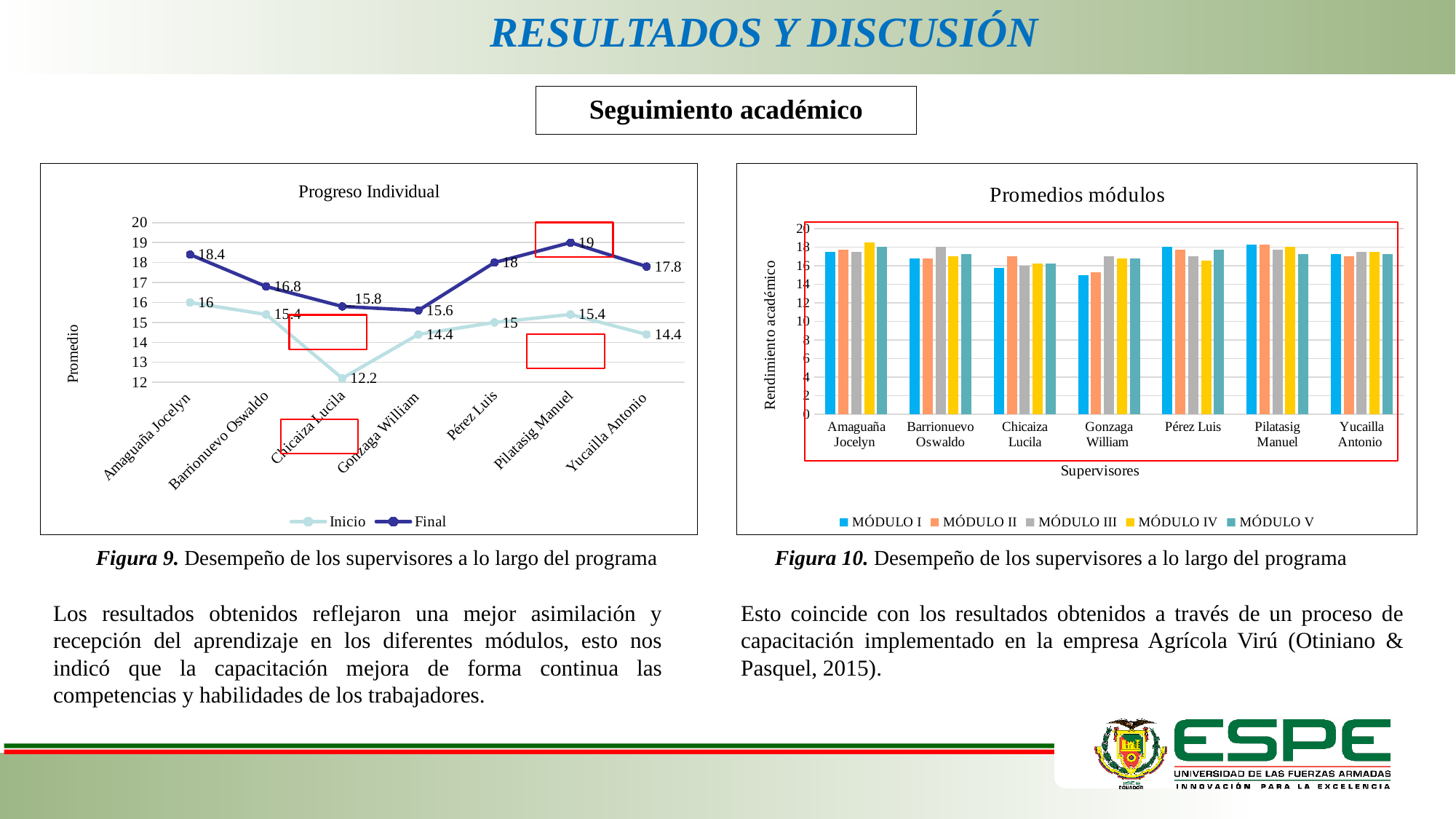
In the 'Promedios módulos' chart, is the MÓDULO I value for Gonzaga William greater or less than 16? less In the 'Progreso Individual' chart, what is the difference between the Final and Inicio values for Amaguaña Jocelyn? 2.4 In the 'Progreso Individual' chart, what is the Final value for Pilatasig Manuel? 19 In the 'Progreso Individual' chart, what is the Inicio value for Chicaiza Lucila? 12.2 In the 'Progreso Individual' chart, what kind of chart is it? line chart In the 'Progreso Individual' chart, which supervisor has the highest Final value? Pilatasig Manuel In the 'Promedios módulos' chart, what kind of chart is it? bar chart In the 'Progreso Individual' chart, which has the larger Inicio value: Pérez Luis or Barrionuevo Oswaldo? Barrionuevo Oswaldo In the 'Progreso Individual' chart, how many supervisors are shown on the x axis? 7 In the 'Promedios módulos' chart, how many series does the legend list? 5 In the 'Promedios módulos' chart, what is the title of the vertical axis? Rendimiento académico In the 'Progreso Individual' chart, which supervisor has the lowest Inicio value? Chicaiza Lucila